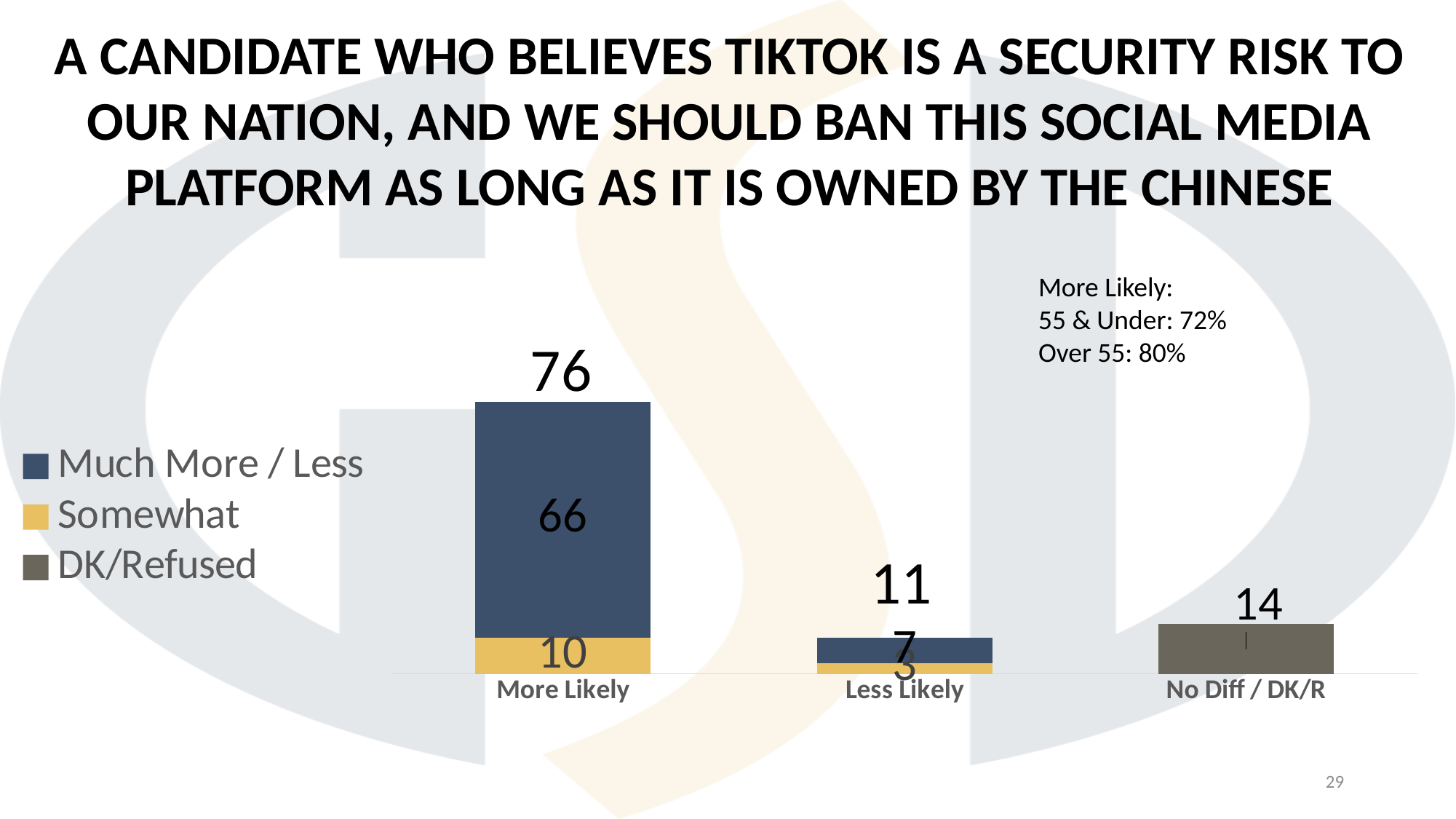
Which category has the highest total? More Likely How many series does the legend list? 3 What is the difference between the More Likely total and the Less Likely total? 65 Which category has the lowest total? Less Likely What is the value for the No Diff / DK/R category? 14 What is the Somewhat value for the More Likely category? 10 What is the Much More / Less value for the More Likely category? 66 What is the Much More / Less value for the Less Likely category? 7 What is the total value shown above the More Likely bar? 76 What is the total value shown above the Less Likely bar? 11 What kind of chart is shown on the slide? Stacked bar chart Which is larger, the Less Likely total or the No Diff / DK/R value? No Diff / DK/R